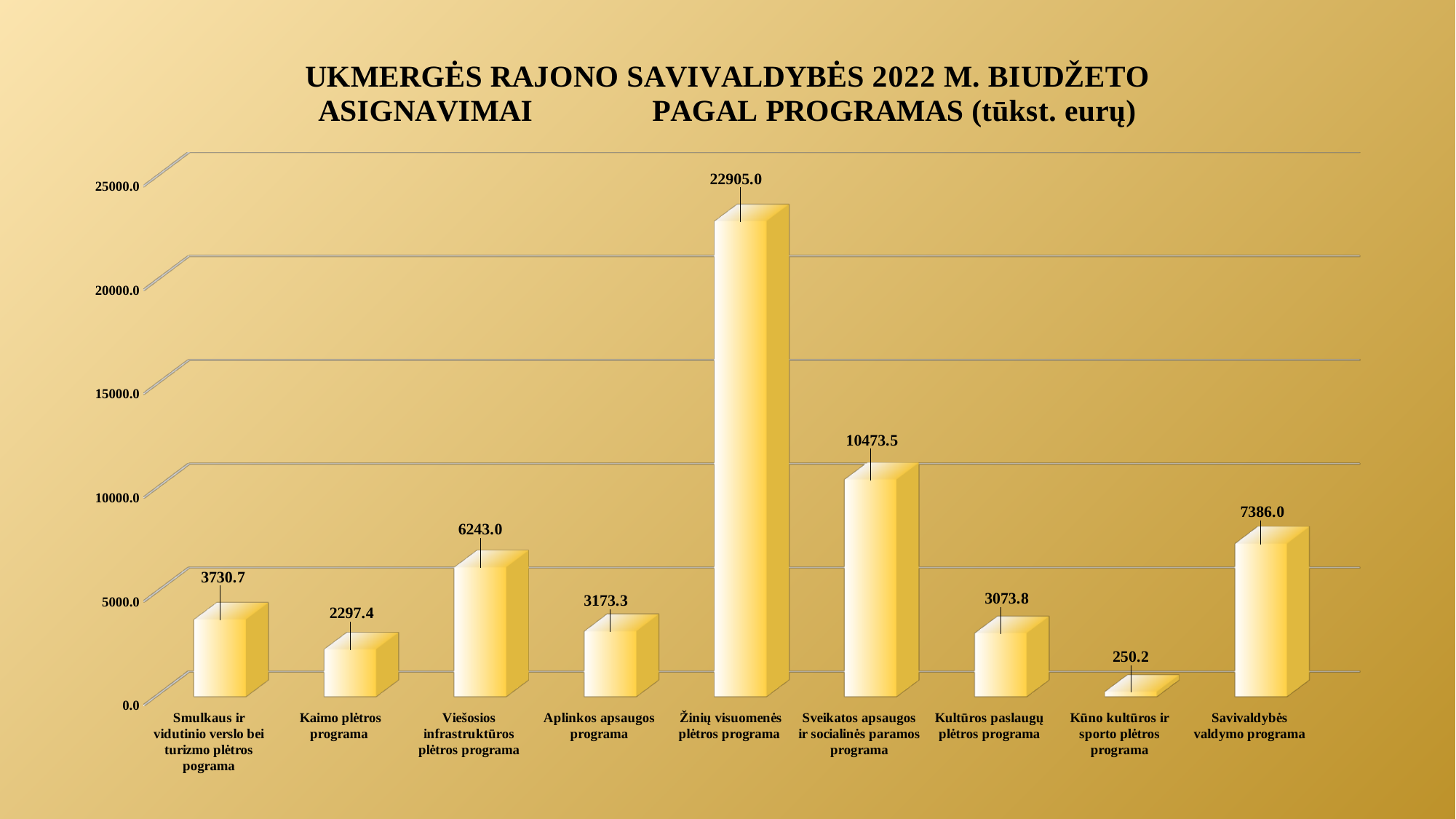
What is the value for Sveikatos apsaugos ir socialinės paramos programa? 10473.5 Which programme has the lowest value? Kūno kultūros ir sporto plėtros programa What is the value for Kūno kultūros ir sporto plėtros programa? 250.2 What is the value for Savivaldybės valdymo programa? 7386.0 Is the value for Sveikatos apsaugos ir socialinės paramos programa greater or less than 10000.0? greater Which is larger, Kaimo plėtros programa or Aplinkos apsaugos programa? Aplinkos apsaugos programa What is the difference between Žinių visuomenės plėtros programa and Sveikatos apsaugos ir socialinės paramos programa? 12431.5 Which programme has the highest value? Žinių visuomenės plėtros programa What is the value for Žinių visuomenės plėtros programa? 22905.0 What is the difference between Savivaldybės valdymo programa and Viešosios infrastruktūros plėtros programa? 1143.0 How many programmes are shown on the chart? 9 What kind of chart is shown on the slide? Bar chart